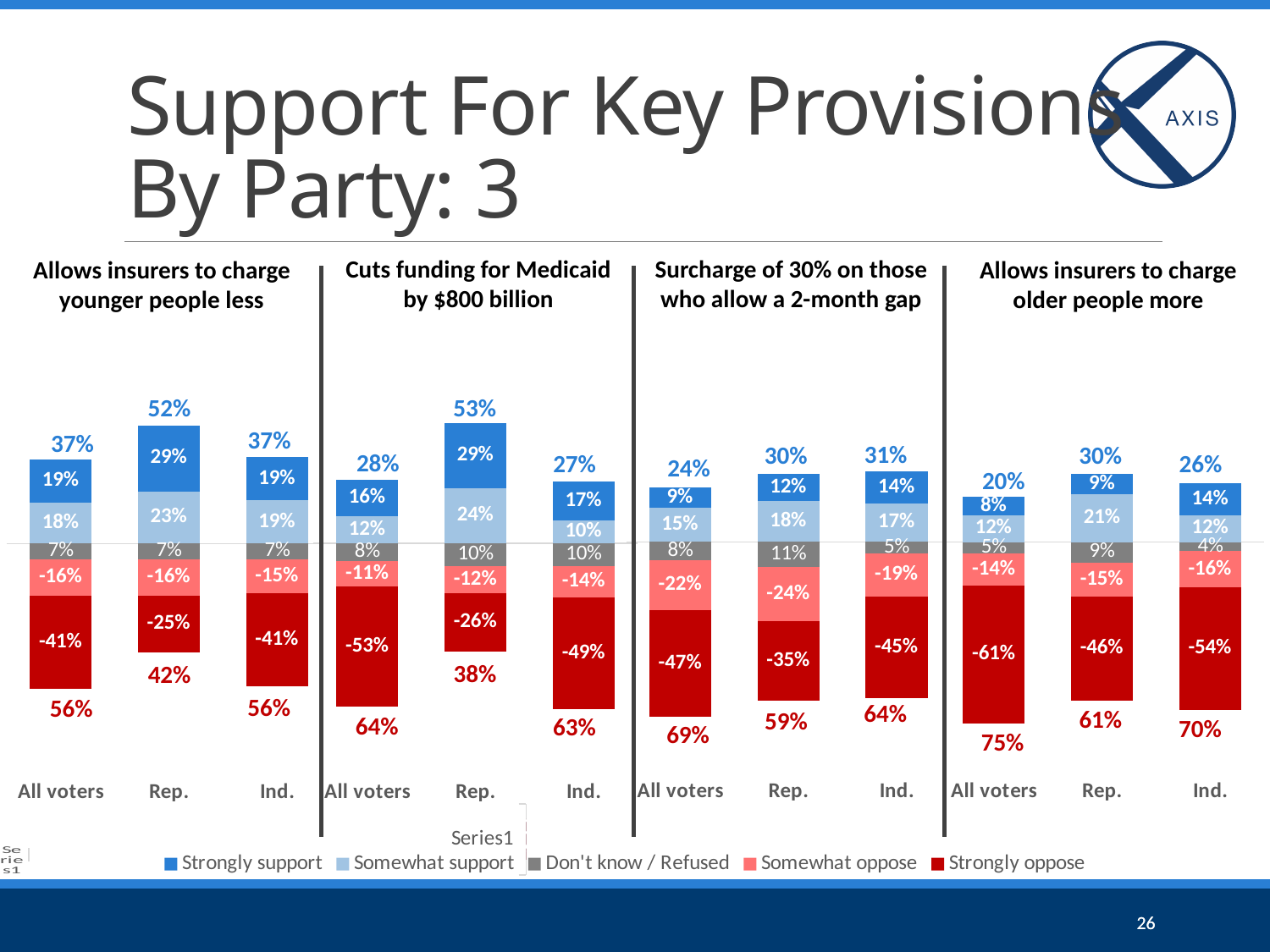
In the chart titled "Surcharge of 30% on those who allow a 2-month gap", which is larger: the total support for Rep. or for Ind.? Ind. In the chart titled "Allows insurers to charge older people more", what is the Don't know / Refused value for Ind.? 4% How many groups (categories) are shown on the x axis of the chart titled "Cuts funding for Medicaid by $800 billion"? 3 In the chart titled "Allows insurers to charge older people more", what is the Somewhat support value for Rep.? 21% How many entries does the legend at the bottom of the slide list? 5 In the chart titled "Cuts funding for Medicaid by $800 billion", which group has the lowest total support percentage? Ind. In the chart titled "Cuts funding for Medicaid by $800 billion", what is the Strongly oppose value for All voters? -53% In the chart titled "Allows insurers to charge younger people less", what is the total support percentage shown above the Rep. bar? 52% In the chart titled "Surcharge of 30% on those who allow a 2-month gap", what is the total oppose percentage shown below the All voters bar? 69% What kind of chart is used on this slide? Stacked bar chart In the chart titled "Allows insurers to charge younger people less", what is the difference between the total oppose percentages for All voters and Rep.? 14% In the chart titled "Allows insurers to charge older people more", which group has the highest total oppose percentage? All voters